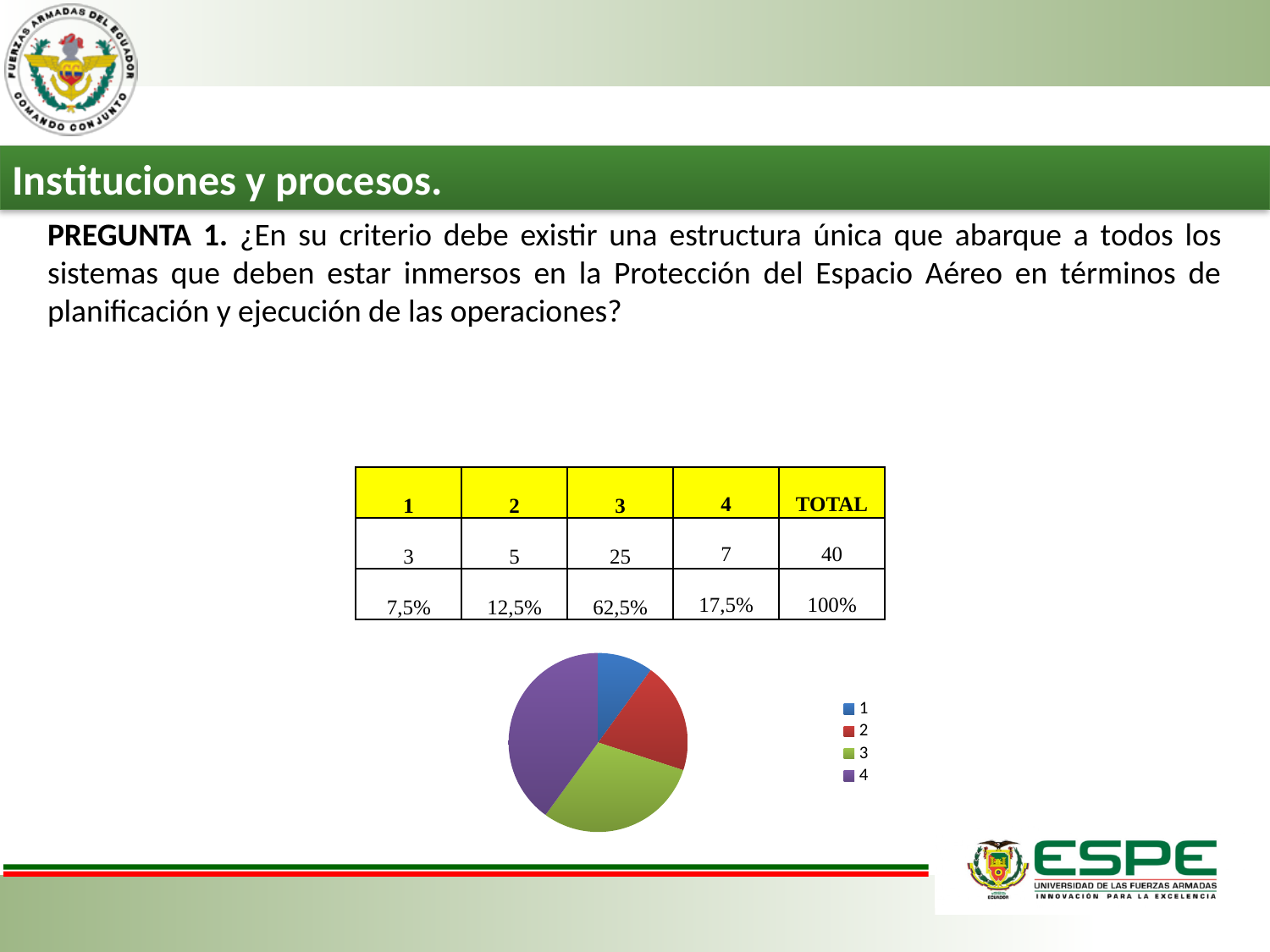
In the pie chart, which slice is larger, category 2 or category 1? 2 How many entries does the pie chart's legend list? 4 What colour represents category 3 in the pie chart? green Which category has the largest slice in the pie chart? 4 What kind of chart is shown on the slide? pie chart What colour represents category 1 in the pie chart? blue In the pie chart, which slice is larger, category 3 or category 2? 3 In the pie chart, which slice is larger, category 4 or category 3? 4 How many slices does the pie chart have? 4 Which category has the smallest slice in the pie chart? 1